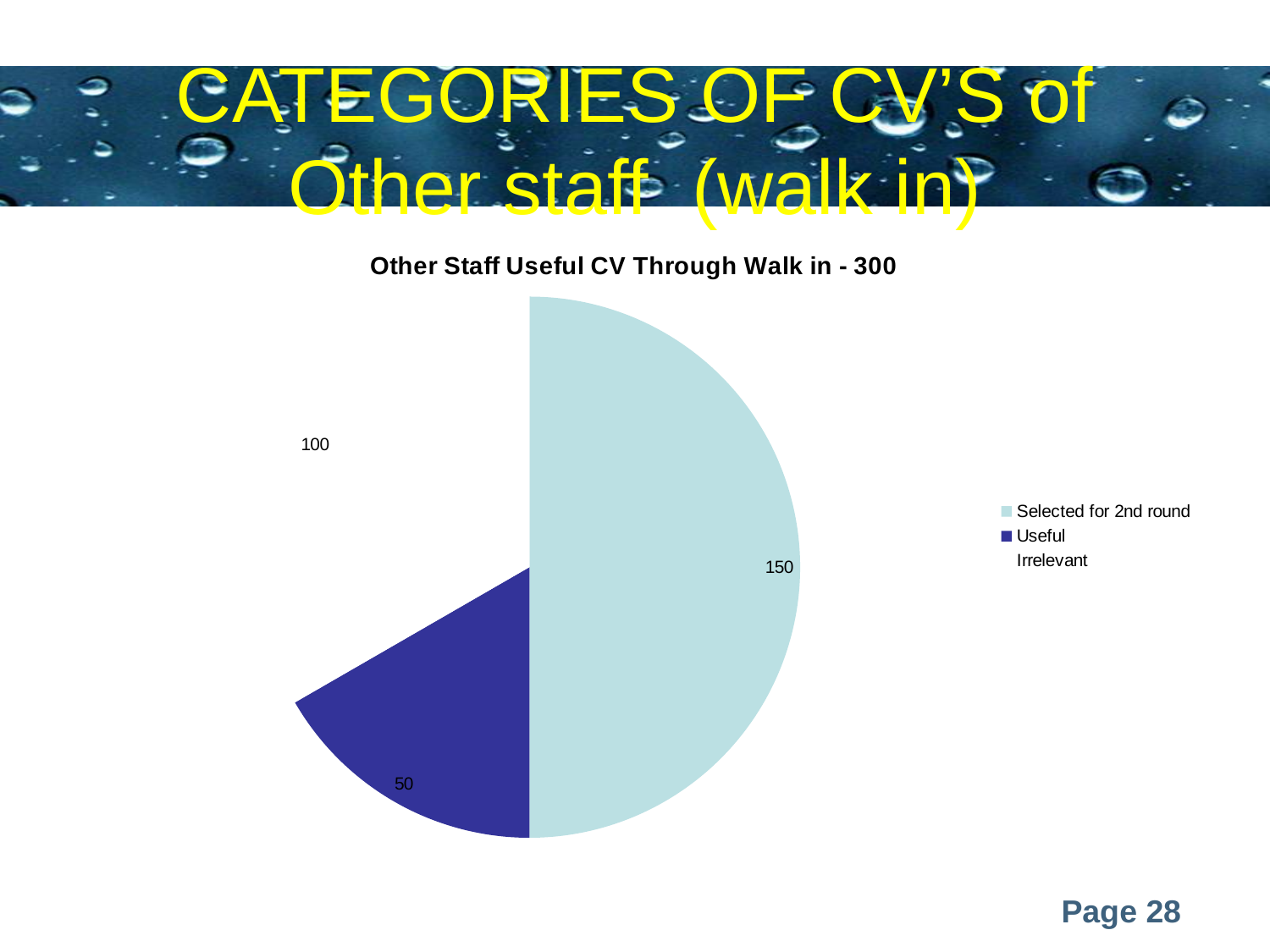
What type of chart is shown on the slide? Pie chart Which category has the smallest slice of the pie? Useful What is the value for Useful? 50 How many entries does the chart legend list? 3 What is the total of all slices in the pie? 300 What is the value for Selected for 2nd round? 150 What is the difference between the values for Selected for 2nd round and Useful? 100 What share of the pie does Selected for 2nd round represent? 50% What is the value for Irrelevant? 100 What is the title of the chart? Other Staff Useful CV Through Walk in - 300 Which is larger, the value for Irrelevant or the value for Useful? Irrelevant Which category has the largest slice of the pie? Selected for 2nd round